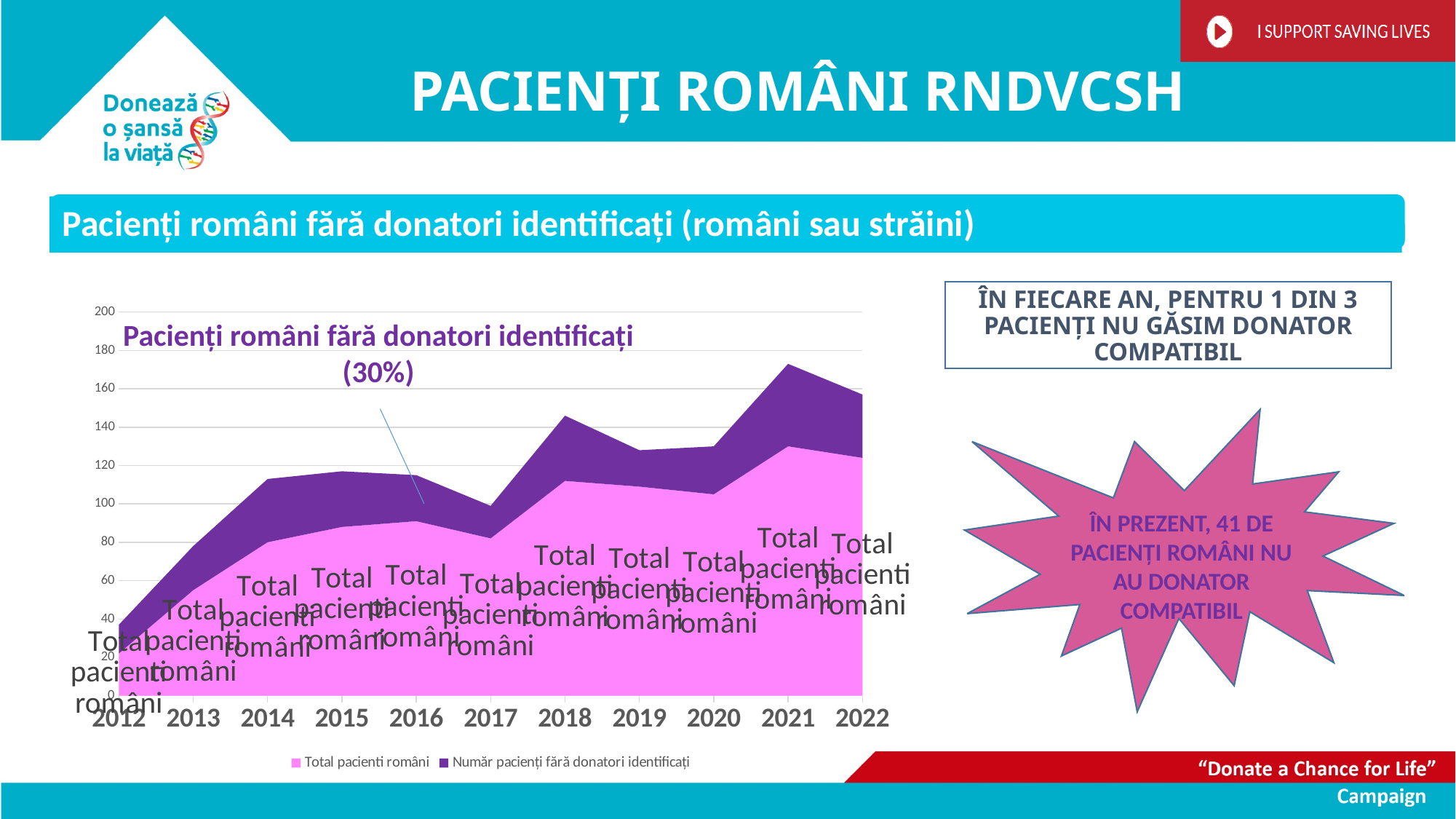
What is the first year shown on the x axis of the chart? 2012 In which year is the stacked total at its lowest? 2012 Which series is shown in pink in the chart? Total pacienti români Which year has the larger stacked total, 2017 or 2018? 2018 In which year does the stacked total reach its highest point? 2021 Does the value for Total pacienti români rise or fall from 2012 to 2014? rise How many series does the chart legend list? 2 Is the value for Total pacienti români in 2022 greater or less than 100? greater Is the value for Total pacienti români in 2018 greater or less than 100? greater Is the stacked total in 2021 greater or less than 160? greater What kind of chart is shown on the slide? Area chart How many years are shown on the x axis of the chart? 11